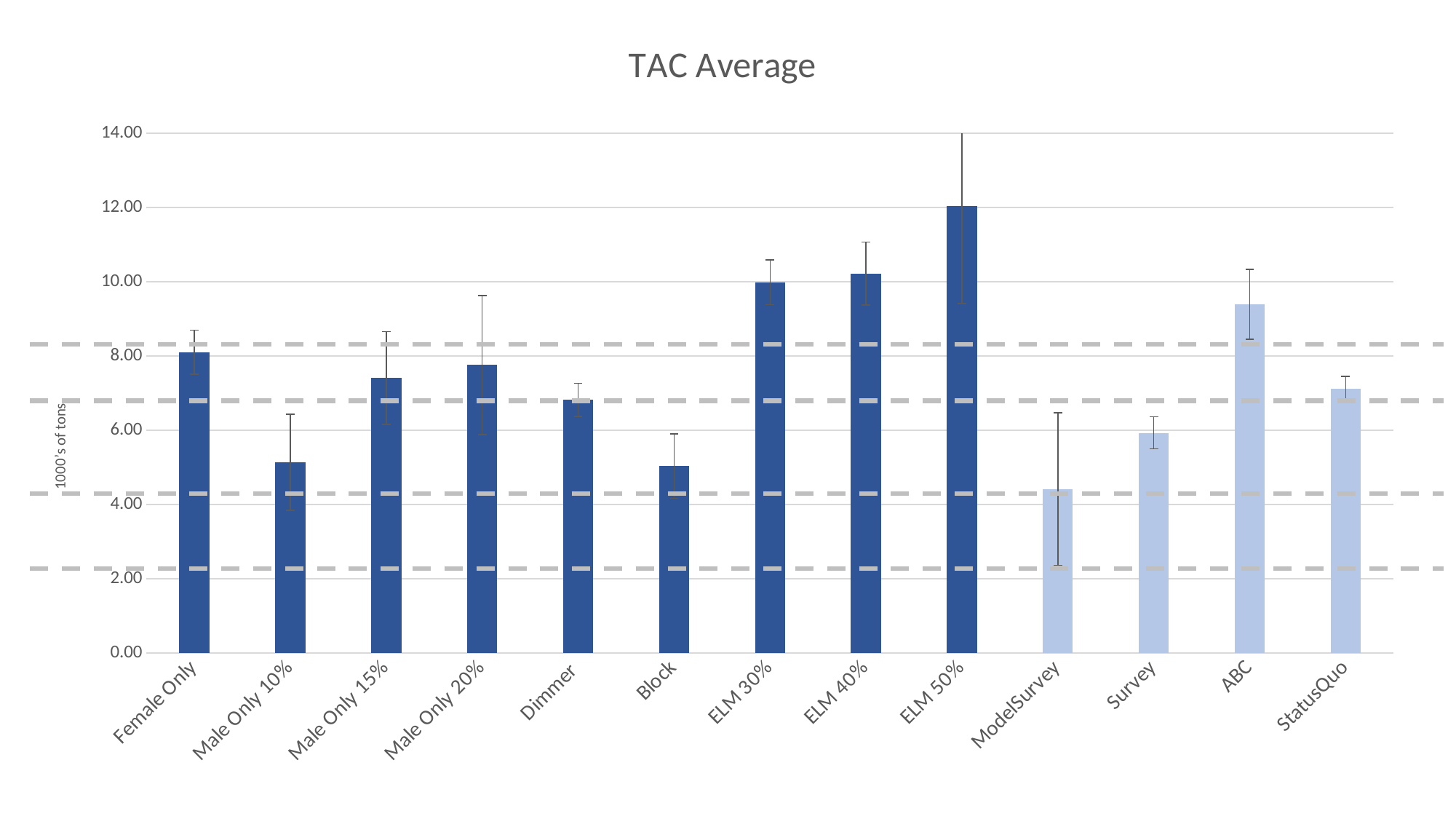
What type of chart is shown on the slide? bar chart Is the value for ABC greater or less than 8.00? greater Which has the larger value, ABC or Survey? ABC What is the title of the chart? TAC Average Is the value for ModelSurvey greater or less than 6.00? less Which category has the lowest TAC Average? ModelSurvey Is the value for Block greater or less than 6.00? less Which category has the highest TAC Average? ELM 50% What is the label on the vertical axis of the chart? 1000's of tons How many categories are shown on the x axis of the chart? 13 Which has the larger value, Male Only 15% or Male Only 10%? Male Only 15%